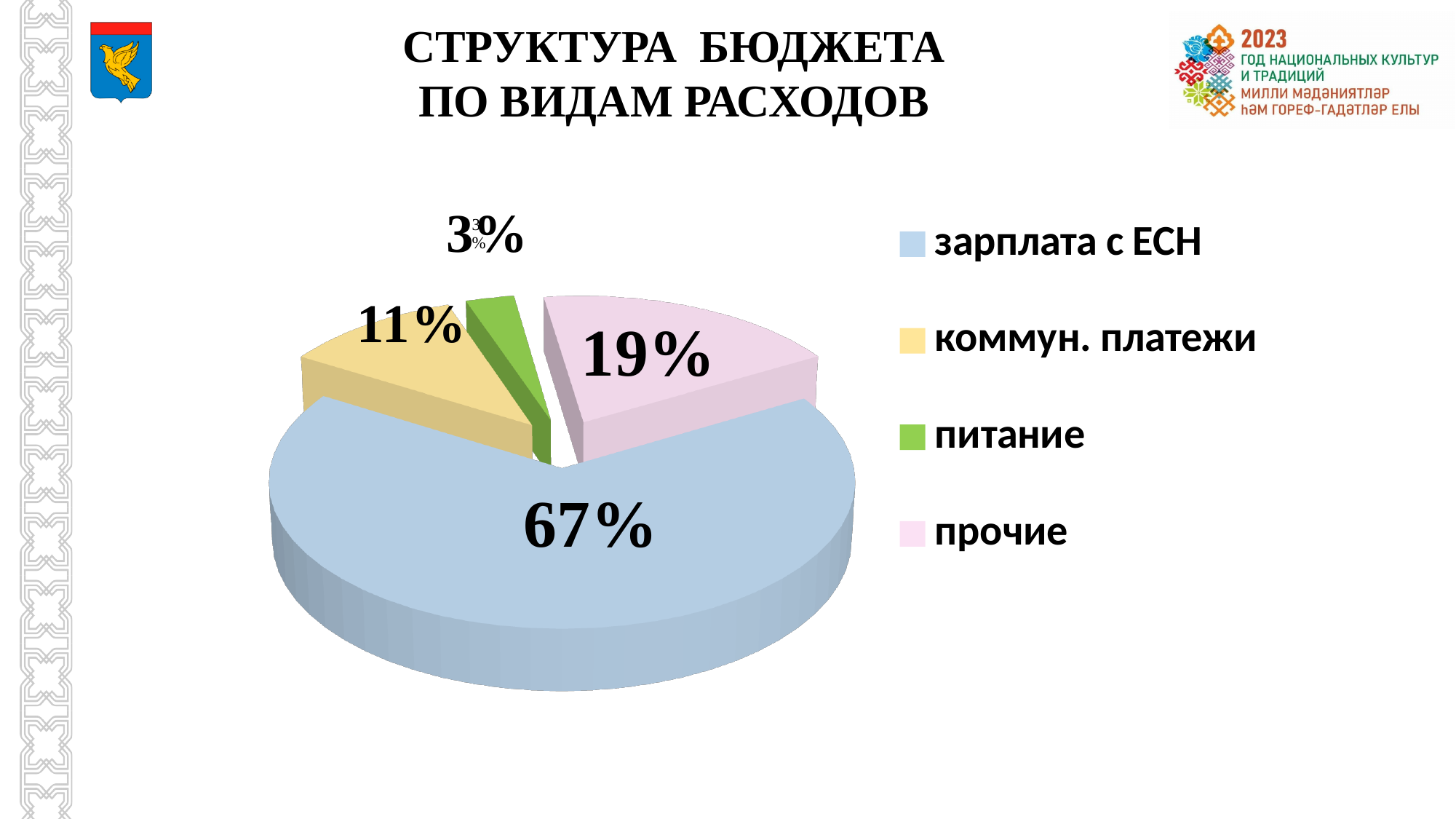
What colour is the slice for питание? green What share of the budget is labelled for прочие? 19% Which category has the largest slice of the pie? зарплата с ЕСН What share of the budget is labelled for зарплата с ЕСН? 67% What is the difference in percentage points between прочие and коммун. платежи? 8 Which category has the smallest slice of the pie? питание Which is larger, the slice for прочие or the slice for коммун. платежи? прочие What is the title of the chart on the slide? СТРУКТУРА БЮДЖЕТА ПО ВИДАМ РАСХОДОВ How many categories does the pie chart show? 4 What share of the budget is labelled for питание? 3% What kind of chart is shown on the slide? pie chart What share of the budget is labelled for коммун. платежи? 11%